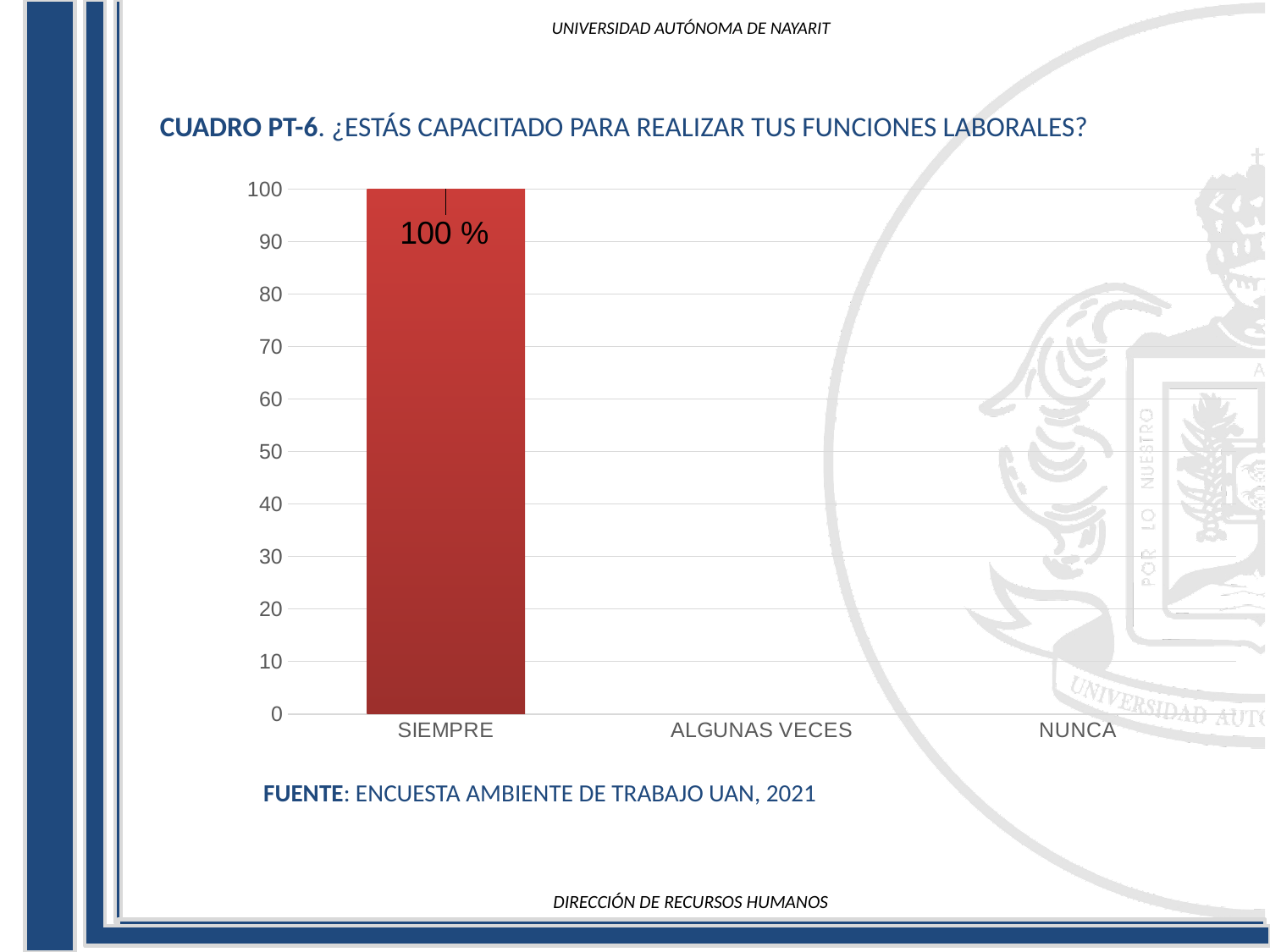
Which is larger, the value for SIEMPRE or the value for ALGUNAS VECES? SIEMPRE What is the value for SIEMPRE? 100 % What is the highest tick value shown on the y axis? 100 Which category has the highest value? SIEMPRE What is the source cited below the chart? ENCUESTA AMBIENTE DE TRABAJO UAN, 2021 Is the value for SIEMPRE greater or less than 90? greater What is the title of the chart? CUADRO PT-6. ¿ESTÁS CAPACITADO PARA REALIZAR TUS FUNCIONES LABORALES? What kind of chart is shown on the slide? bar chart How many categories are shown on the x axis? 3 Which is larger, the value for SIEMPRE or the value for NUNCA? SIEMPRE